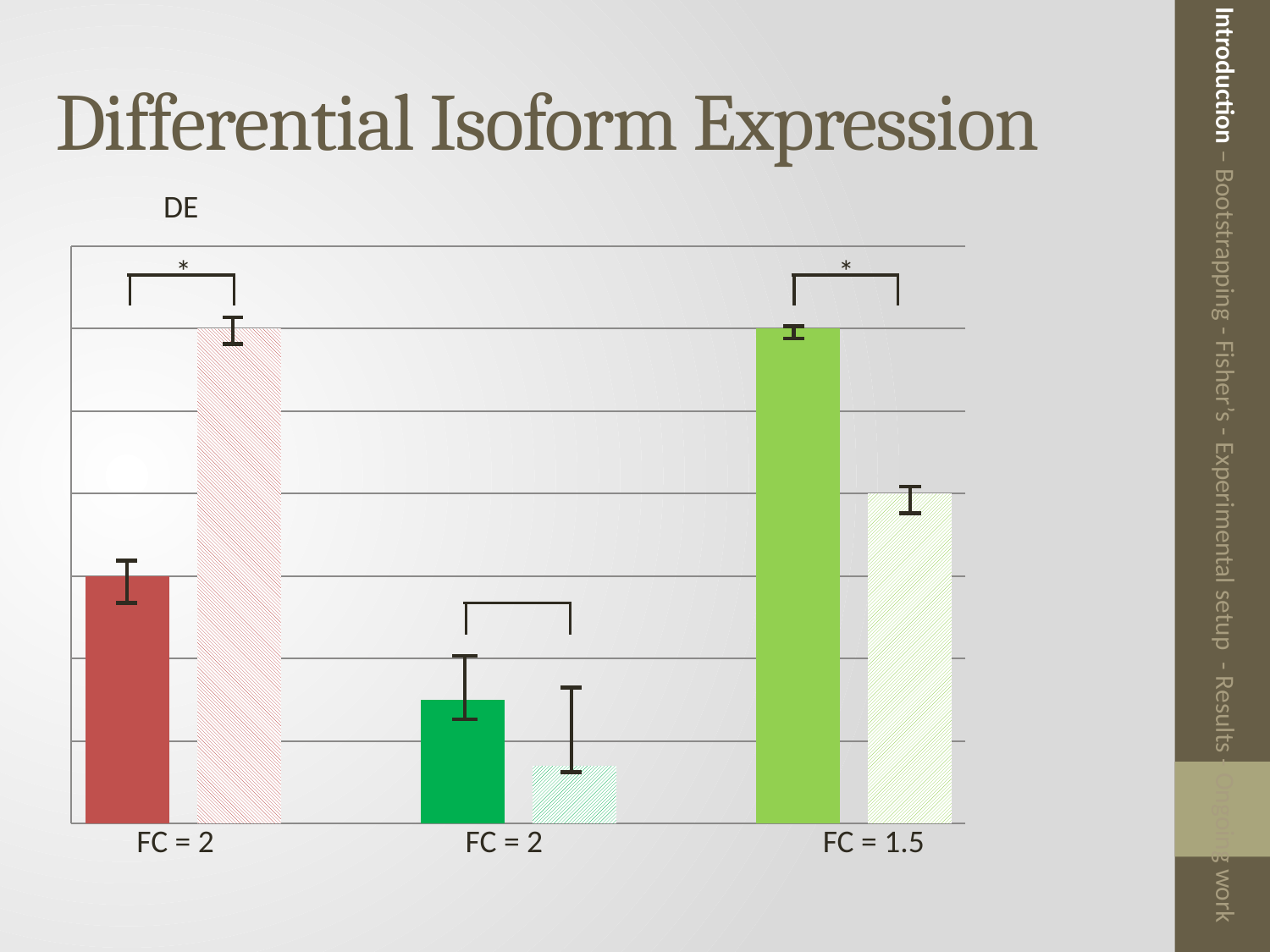
In the middle FC = 2 group, which bar is taller, the solid green bar or the hatched bar? the solid green bar Which groups are marked with an asterisk above them? the leftmost FC = 2 group and the FC = 1.5 group Which group contains the shortest bar in the chart? the middle FC = 2 group What is the title of the chart? DE Is the solid bar in the middle FC = 2 group taller or shorter than the solid bar in the leftmost FC = 2 group? shorter In the leftmost FC = 2 group, which bar is taller, the solid red bar or the hatched bar? the hatched bar What is the x-axis label of the rightmost category? FC = 1.5 How many categories are shown along the x axis of the chart? 3 What kind of chart is shown on the slide? bar chart How many bars are plotted in the chart in total? 6